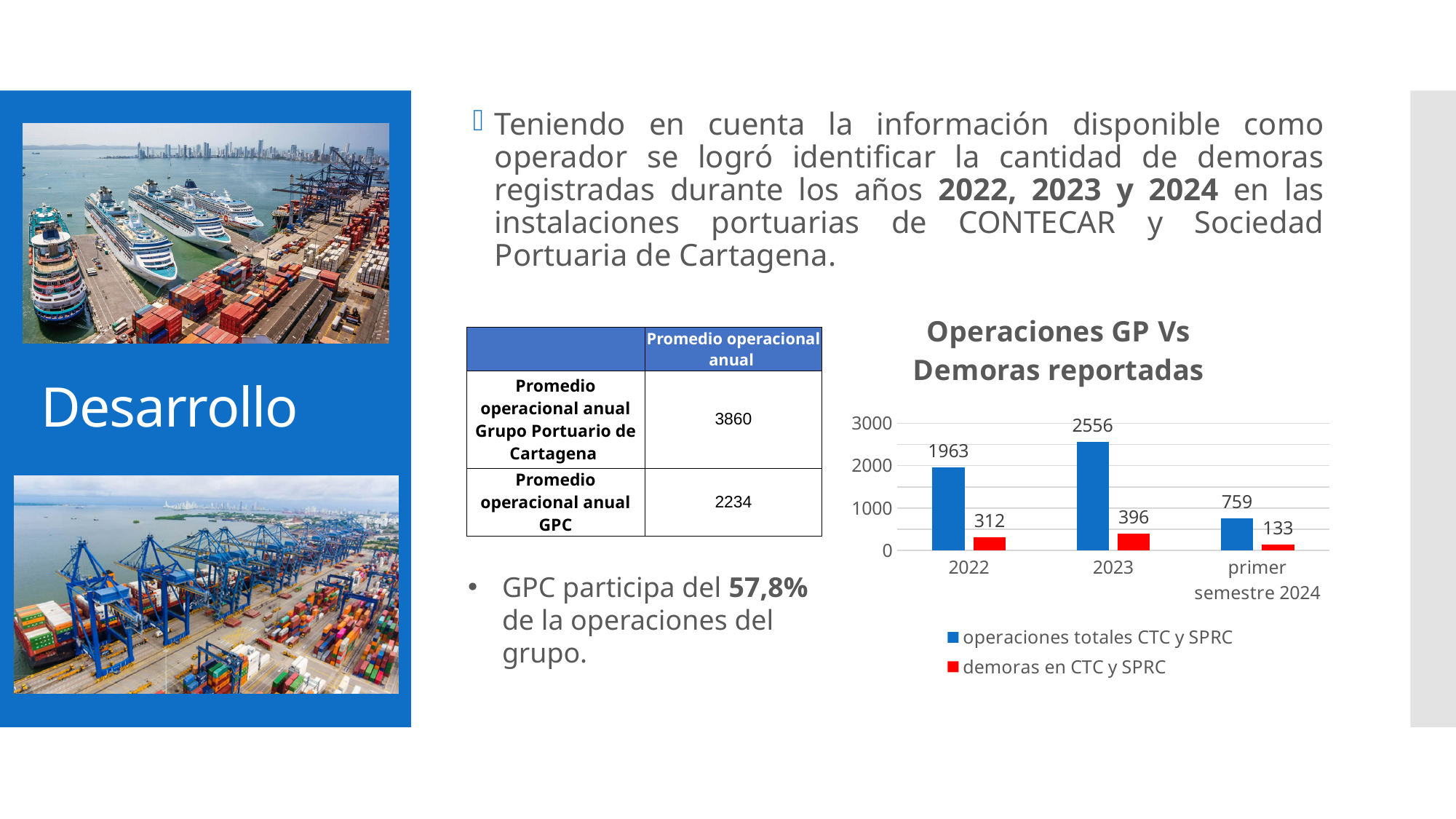
Is the value for 'operaciones totales CTC y SPRC' in 2023 greater or less than 2000? greater How many categories are shown on the x axis of the chart? 3 Which category has the highest value for 'operaciones totales CTC y SPRC'? 2023 What is the value of 'operaciones totales CTC y SPRC' for primer semestre 2024? 759 Which is larger: 'demoras en CTC y SPRC' in 2022 or in 2023? 2023 What is the difference between 'operaciones totales CTC y SPRC' in 2023 and 2022? 593 How many series does the chart legend list? 2 Which category has the lowest value for 'demoras en CTC y SPRC'? primer semestre 2024 What is the value of 'operaciones totales CTC y SPRC' for 2022? 1963 What is the title of the chart? Operaciones GP Vs Demoras reportadas What is the value of 'demoras en CTC y SPRC' for 2023? 396 What kind of chart is shown on the slide? bar chart